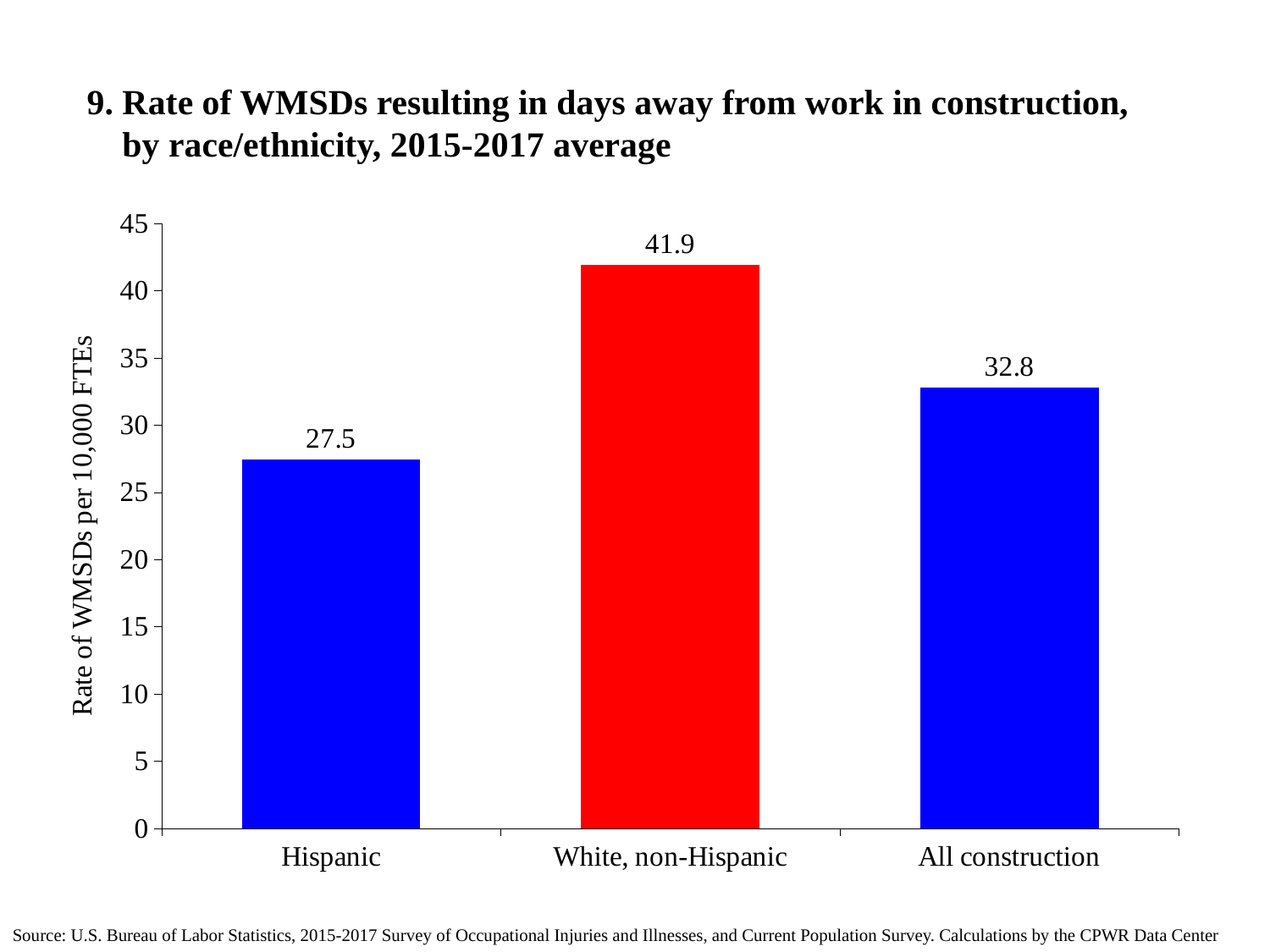
What kind of chart is shown on the slide? Bar chart Which is larger, the WMSD rate for All construction or for Hispanic workers? All construction Which category has the highest rate of WMSDs? White, non-Hispanic Is the value for White, non-Hispanic greater or less than 40? greater How many categories are shown on the x axis? 3 What is the rate of WMSDs per 10,000 FTEs for Hispanic construction workers? 27.5 Which category has the lowest rate of WMSDs? Hispanic What is the difference between the WMSD rate for All construction and Hispanic workers? 5.3 Which bar is coloured red? White, non-Hispanic What is the difference between the WMSD rate for White, non-Hispanic and Hispanic workers? 14.4 What is the rate of WMSDs per 10,000 FTEs for White, non-Hispanic construction workers? 41.9 What is the rate of WMSDs per 10,000 FTEs for All construction? 32.8